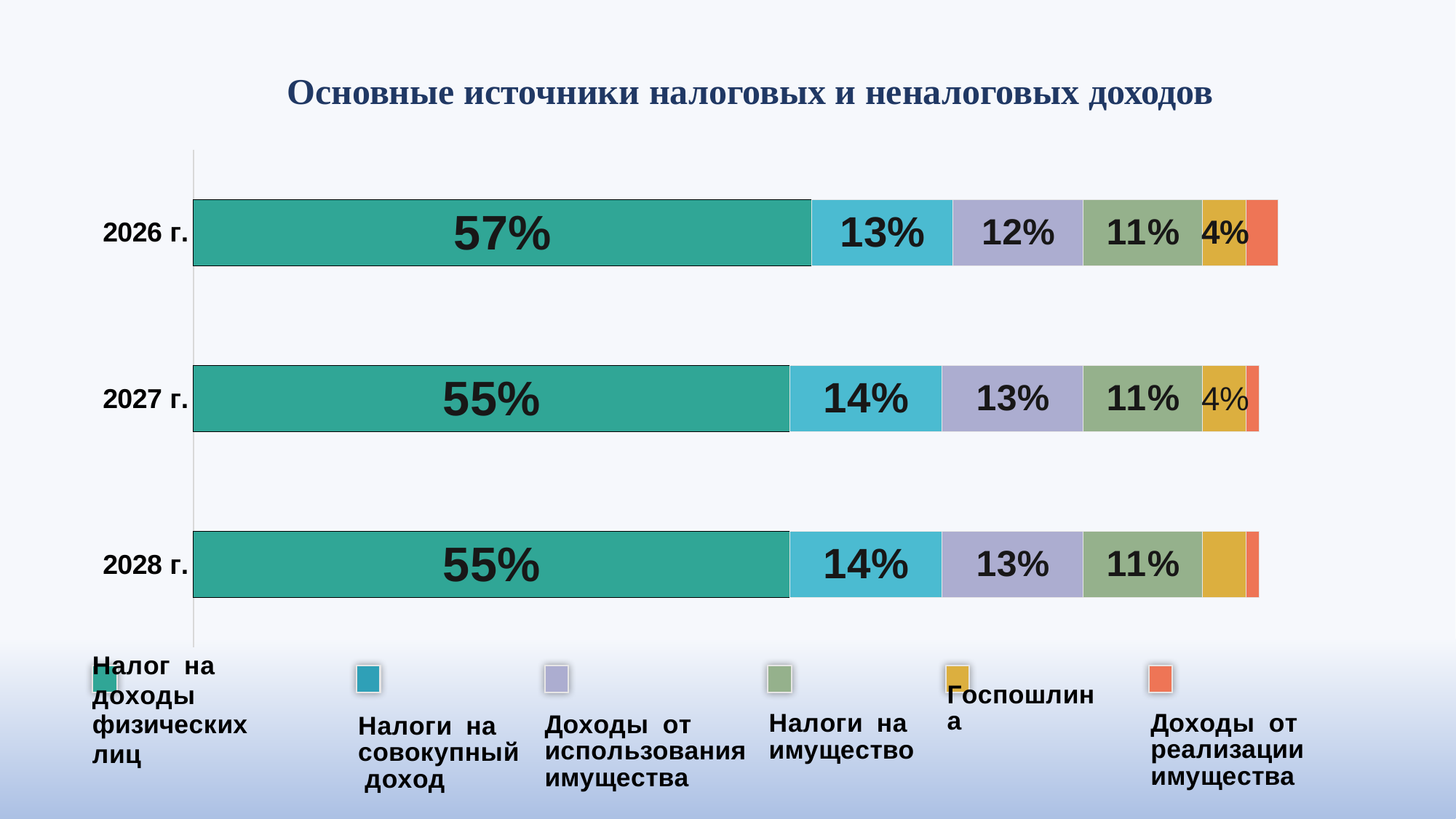
What is the share of Налог на доходы физических лиц in 2026 г.? 57% How many series does the legend list? 6 What is the title of the chart? Основные источники налоговых и неналоговых доходов How many years are shown on the chart? 3 What type of chart is shown on the slide? stacked bar chart What is the share of Госпошлина in 2027 г.? 4% What is the difference between the share of Налог на доходы физических лиц in 2026 г. and in 2027 г.? 2% Which is larger in 2026 г.: the share of Налоги на совокупный доход or the share of Доходы от использования имущества? Налоги на совокупный доход What is the share of Налоги на имущество in 2026 г.? 11% What is the share of Доходы от использования имущества in 2028 г.? 13% What is the share of Налоги на совокупный доход in 2027 г.? 14% In which year is the share of Налог на доходы физических лиц the highest? 2026 г.